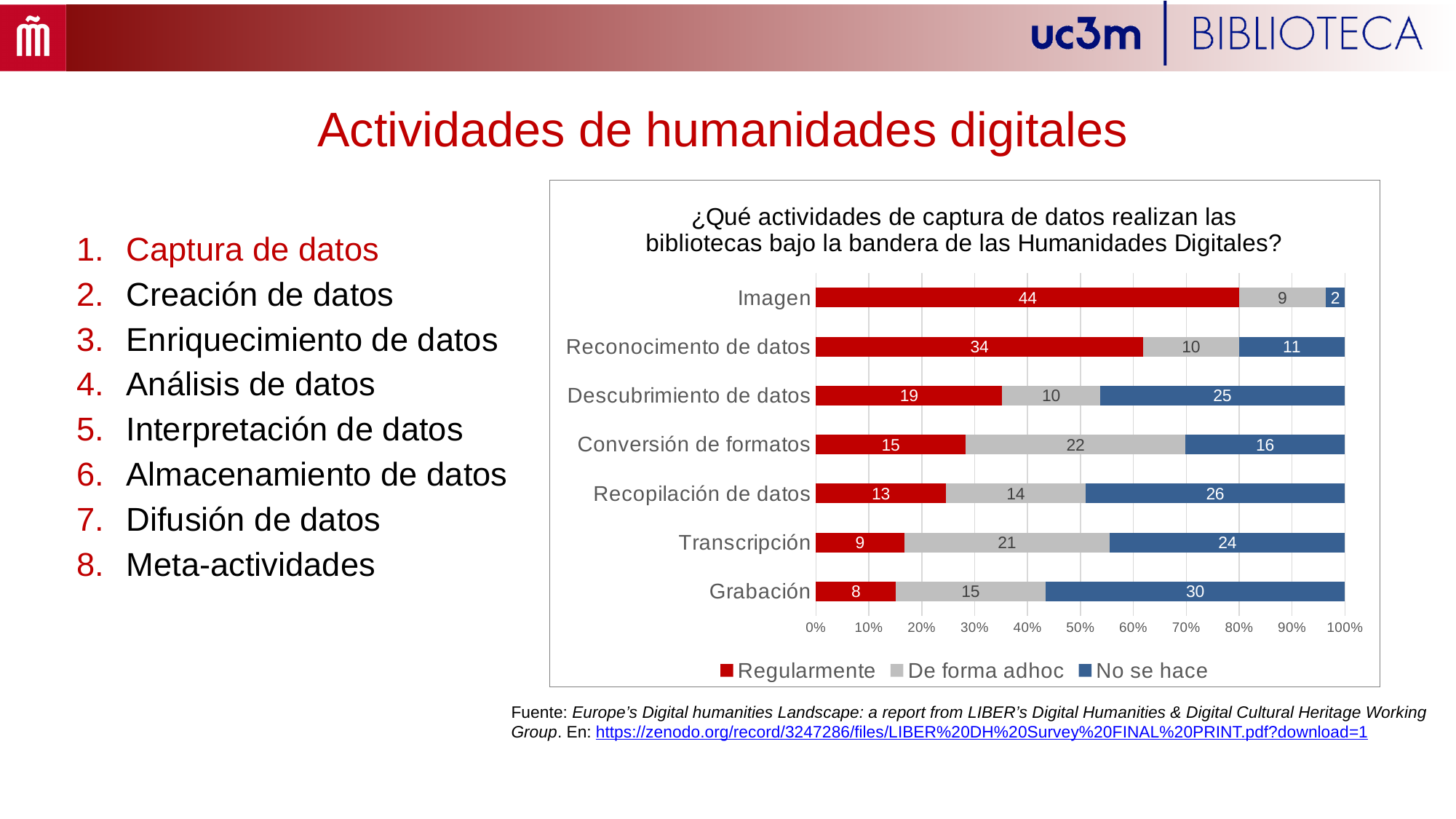
Which is larger: the "No se hace" value for Descubrimiento de datos or for Transcripción? Descubrimiento de datos What is the title of the chart? ¿Qué actividades de captura de datos realizan las bibliotecas bajo la bandera de las Humanidades Digitales? How many series does the legend list? 3 What is the total of the stacked bar for Recopilación de datos? 53 What is the value of "De forma adhoc" for Conversión de formatos? 22 What is the value of "No se hace" for Grabación? 30 Which category has the highest "Regularmente" value? Imagen What is the value of "Regularmente" for Imagen? 44 Which category has the lowest "No se hace" value? Imagen What is the difference between the "Regularmente" values for Imagen and Reconocimento de datos? 10 How many categories are shown on the chart? 7 What kind of chart is shown on the slide? Stacked bar chart